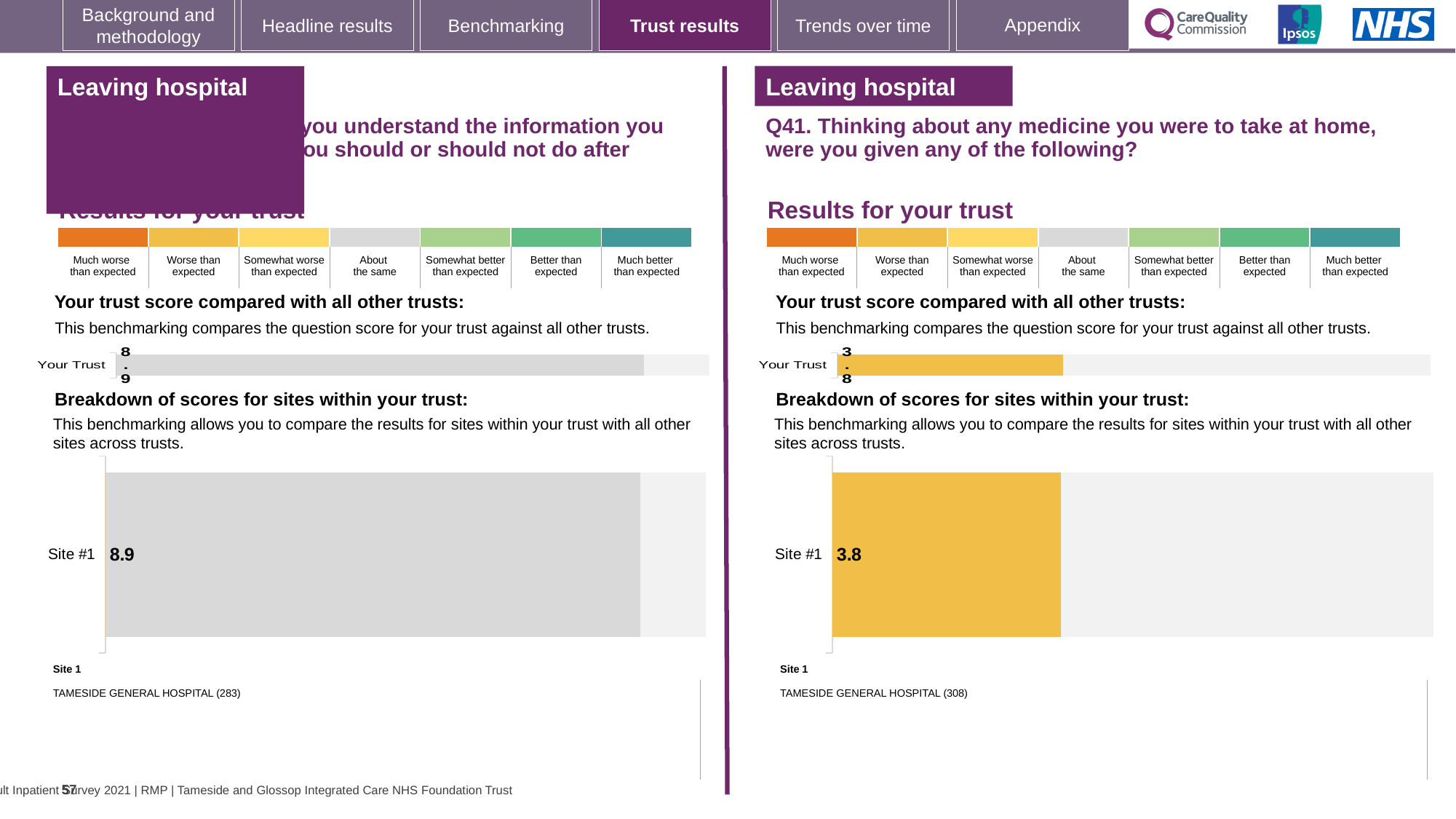
On the left-hand panel's site breakdown chart, what is the score for Site #1? 8.9 What kind of chart is used to show the Site #1 score on the left-hand panel? Bar chart What is the difference between the Site #1 score on the left-hand panel and the Site #1 score on the right-hand panel (Q41)? 5.1 On the left-hand panel, is the Your Trust score greater or less than the Site #1 score, or are they equal? Equal On the right-hand panel (Q41), what is the score shown for Your Trust? 3.8 On the left-hand panel, what is the score shown for Your Trust? 8.9 Which site name is listed as Site 1 on the right-hand panel (Q41)? TAMESIDE GENERAL HOSPITAL (308) Which is larger: the Your Trust score on the left-hand panel or the Your Trust score on the right-hand panel (Q41)? Left-hand panel How many sites are shown in the site breakdown chart on the right-hand panel (Q41)? 1 On the right-hand panel's site breakdown chart (Q41), what is the score for Site #1? 3.8 On the right-hand panel (Q41), what colour is the Your Trust bar? Yellow/orange